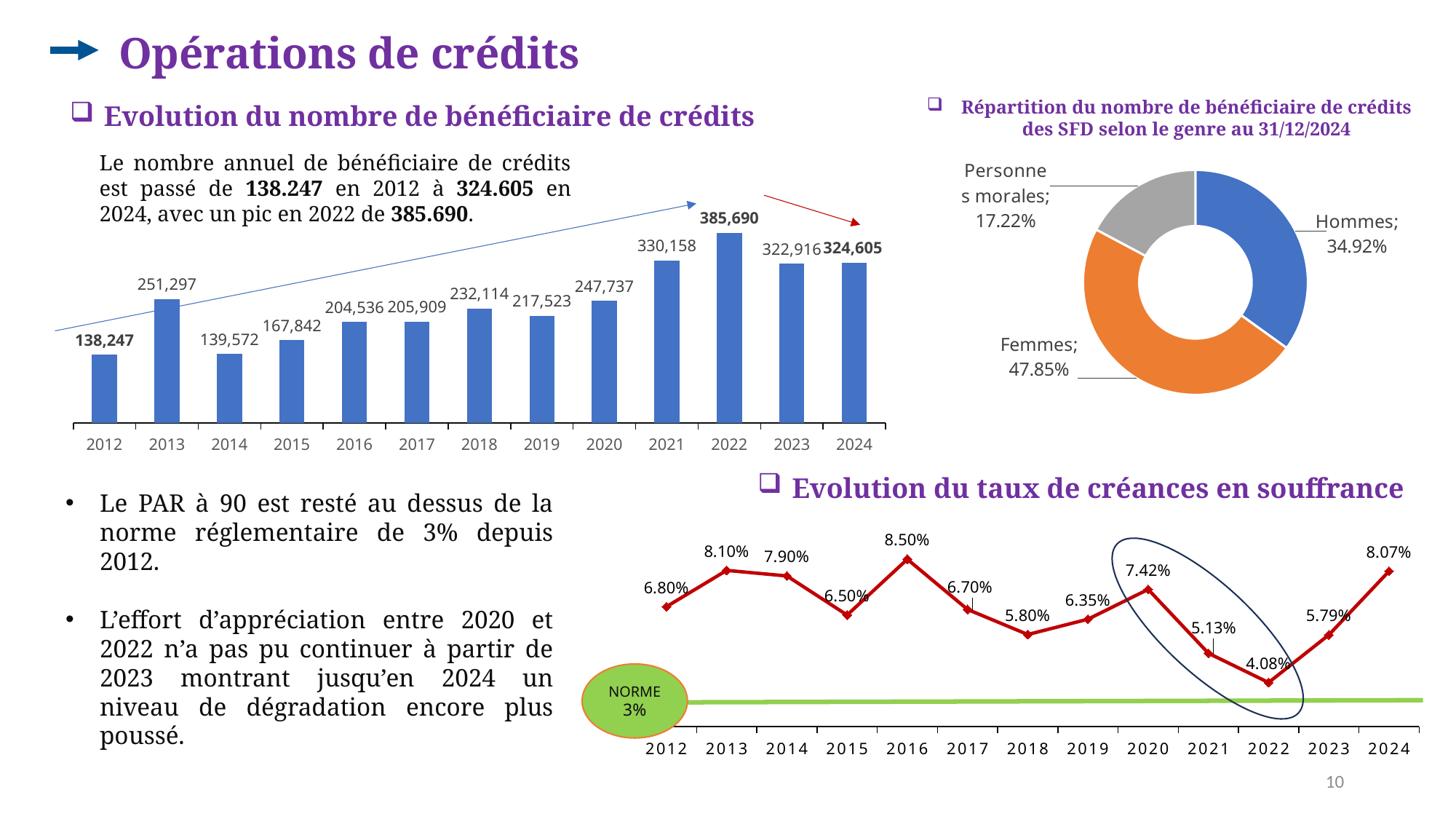
In the 'Evolution du nombre de bénéficiaire de crédits' bar chart, which is larger, the value for 2013 or the value for 2014? 2013 In the 'Répartition du nombre de bénéficiaire de crédits des SFD selon le genre au 31/12/2024' chart, which category has the smallest share? Personnes morales In the 'Evolution du nombre de bénéficiaire de crédits' bar chart, what is the value for 2022? 385,690 In the 'Répartition du nombre de bénéficiaire de crédits des SFD selon le genre au 31/12/2024' chart, what share is Femmes? 47.85% In the 'Evolution du nombre de bénéficiaire de crédits' bar chart, how many years are shown on the x axis? 13 In the 'Evolution du nombre de bénéficiaire de crédits' bar chart, which year has the lowest value? 2012 How many categories does the 'Répartition du nombre de bénéficiaire de crédits des SFD selon le genre au 31/12/2024' chart show? 3 In the 'Evolution du taux de créances en souffrance' line chart, which year has the lowest value? 2022 In the 'Evolution du taux de créances en souffrance' line chart, what is the difference between the 2024 value and the 2023 value? 2.28% In the 'Evolution du taux de créances en souffrance' line chart, what is the value for 2016? 8.50% What kind of chart is 'Evolution du nombre de bénéficiaire de crédits'? Bar chart In the 'Evolution du nombre de bénéficiaire de crédits' bar chart, what is the difference between the 2024 value and the 2023 value? 1,689